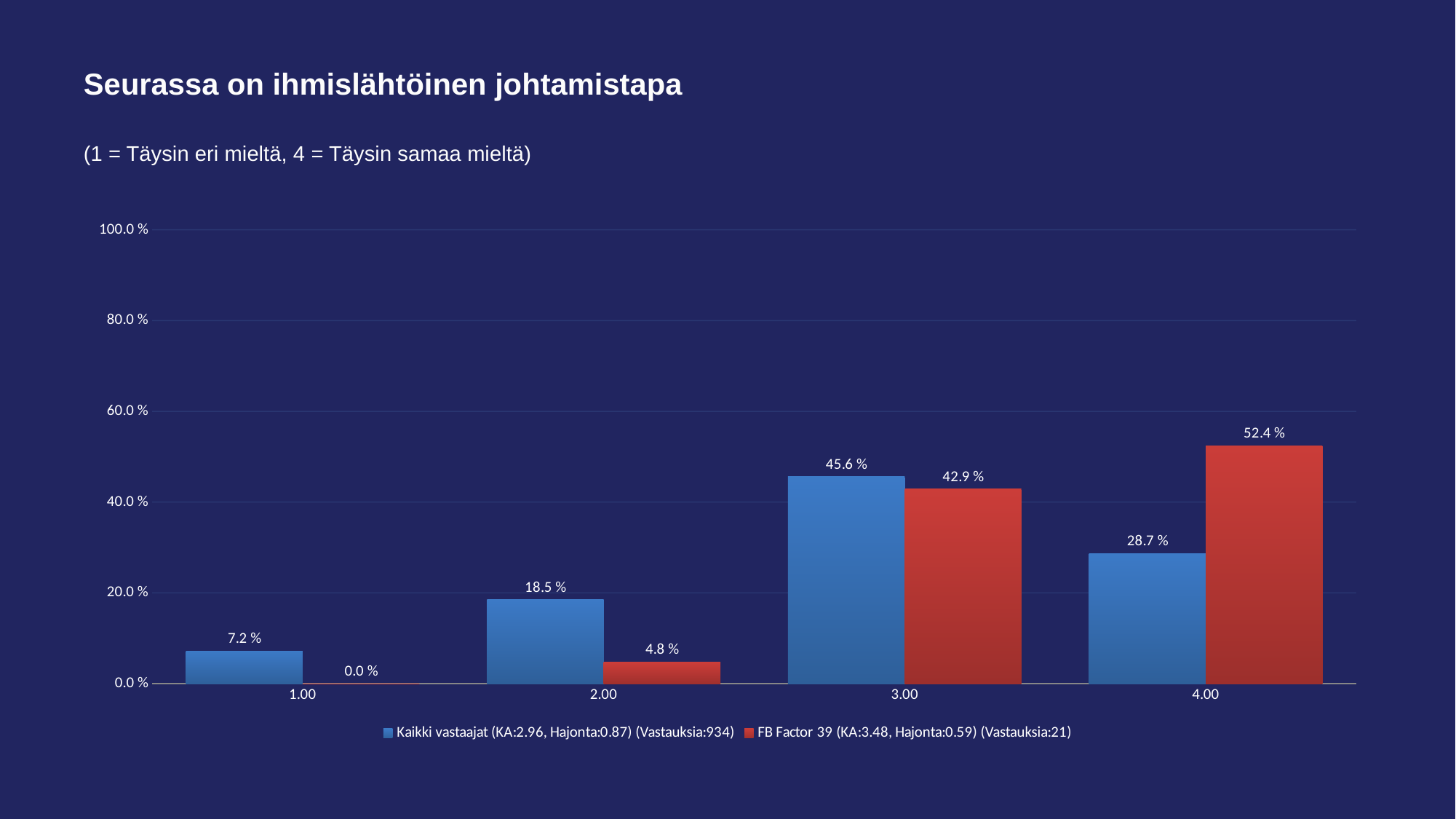
What is the value for FB Factor 39 at 1.00? 0.0 % How many categories are shown on the x axis? 4 What is the difference between FB Factor 39 and Kaikki vastaajat at 4.00? 23.7 % What is the title of the chart? Seurassa on ihmislähtöinen johtamistapa Which category has the lowest value for FB Factor 39? 1.00 At 3.00, which series has the larger value, Kaikki vastaajat or FB Factor 39? Kaikki vastaajat Which category has the highest value for Kaikki vastaajat? 3.00 What is the value for Kaikki vastaajat at 3.00? 45.6 % What is the value for FB Factor 39 at 4.00? 52.4 % What is the value for Kaikki vastaajat at 2.00? 18.5 % What kind of chart is shown on the slide? Bar chart How many series does the legend list? 2